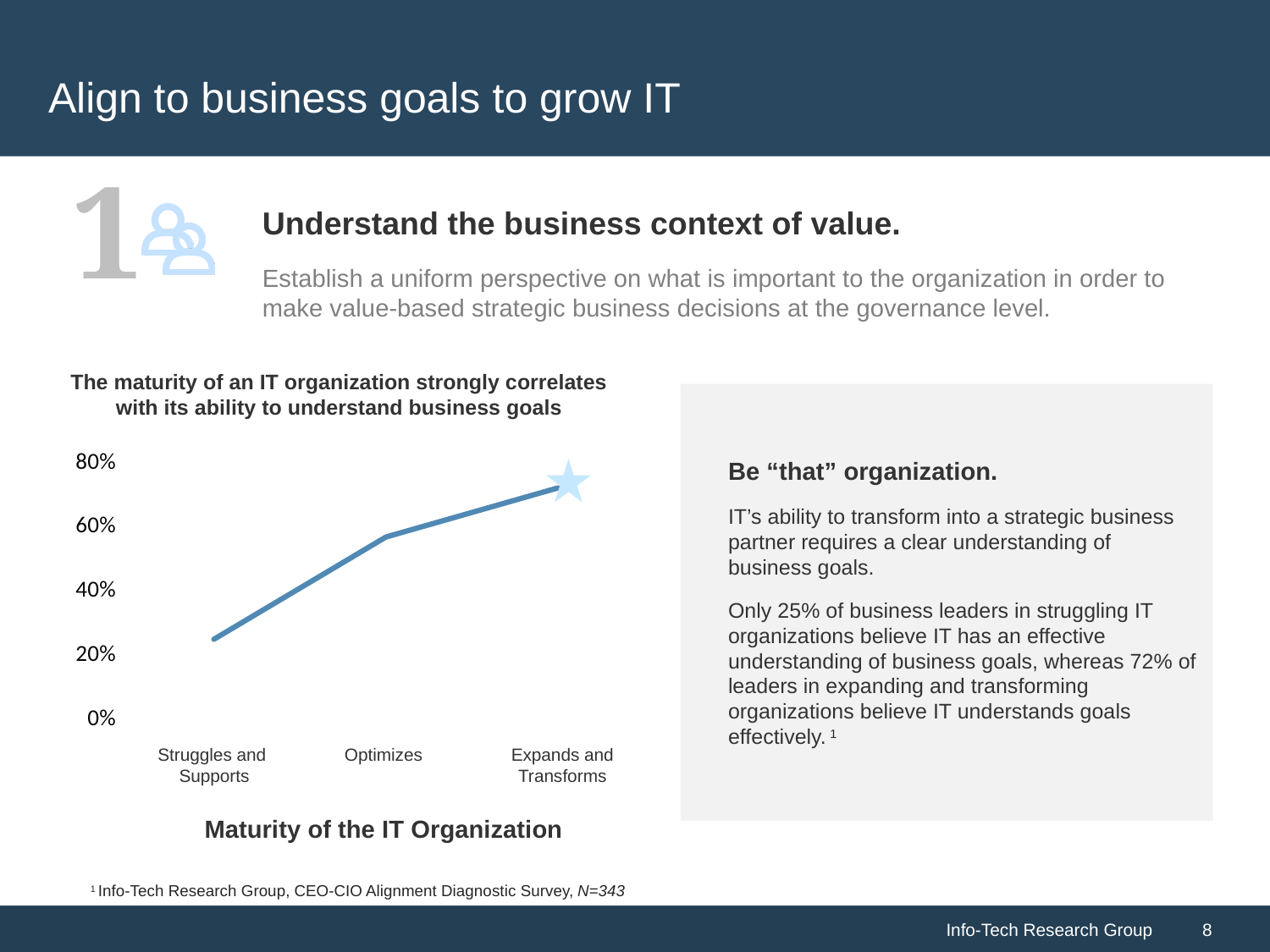
Which maturity category has the lowest value in the chart? Struggles and Supports Which maturity category has the highest value in the chart? Expands and Transforms What is the title of the x axis of the chart? Maturity of the IT Organization Is the value for Expands and Transforms greater or less than 80%? less Is the value for Expands and Transforms greater or less than 60%? greater Is the value for Struggles and Supports greater or less than 20%? greater What kind of chart is shown on the slide? line chart Which has the larger value, Optimizes or Struggles and Supports? Optimizes Do the values rise or fall moving from Struggles and Supports to Expands and Transforms? rise How many maturity categories are plotted along the x axis of the chart? 3